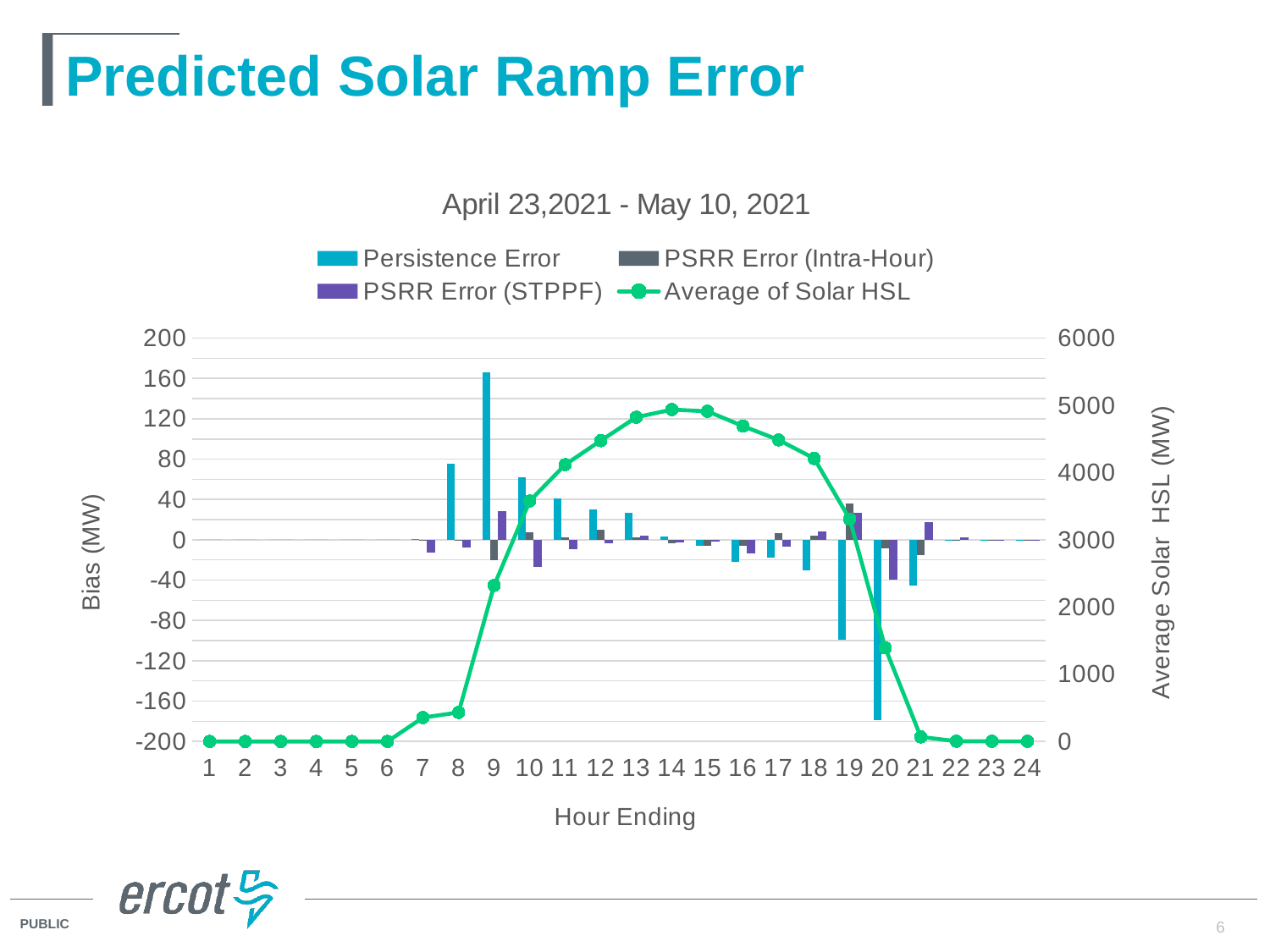
Is the Average of Solar HSL at hour ending 14 greater or less than 4000 MW? greater At which hour ending is the Persistence Error bar the highest? 9 At which hour ending is the Persistence Error bar the lowest (most negative)? 20 What kind of chart is shown on the slide? A combination bar and line chart Is the Persistence Error at hour ending 9 greater or less than 120 MW? greater How many series does the legend list? 4 Which is larger, the Persistence Error at hour ending 9 or at hour ending 8? Hour ending 9 How many hours are shown along the x axis? 24 Is the Persistence Error at hour ending 20 greater or less than -120 MW? less Does the Average of Solar HSL rise or fall from hour ending 9 to hour ending 14? rise What is the title of the x axis? Hour Ending